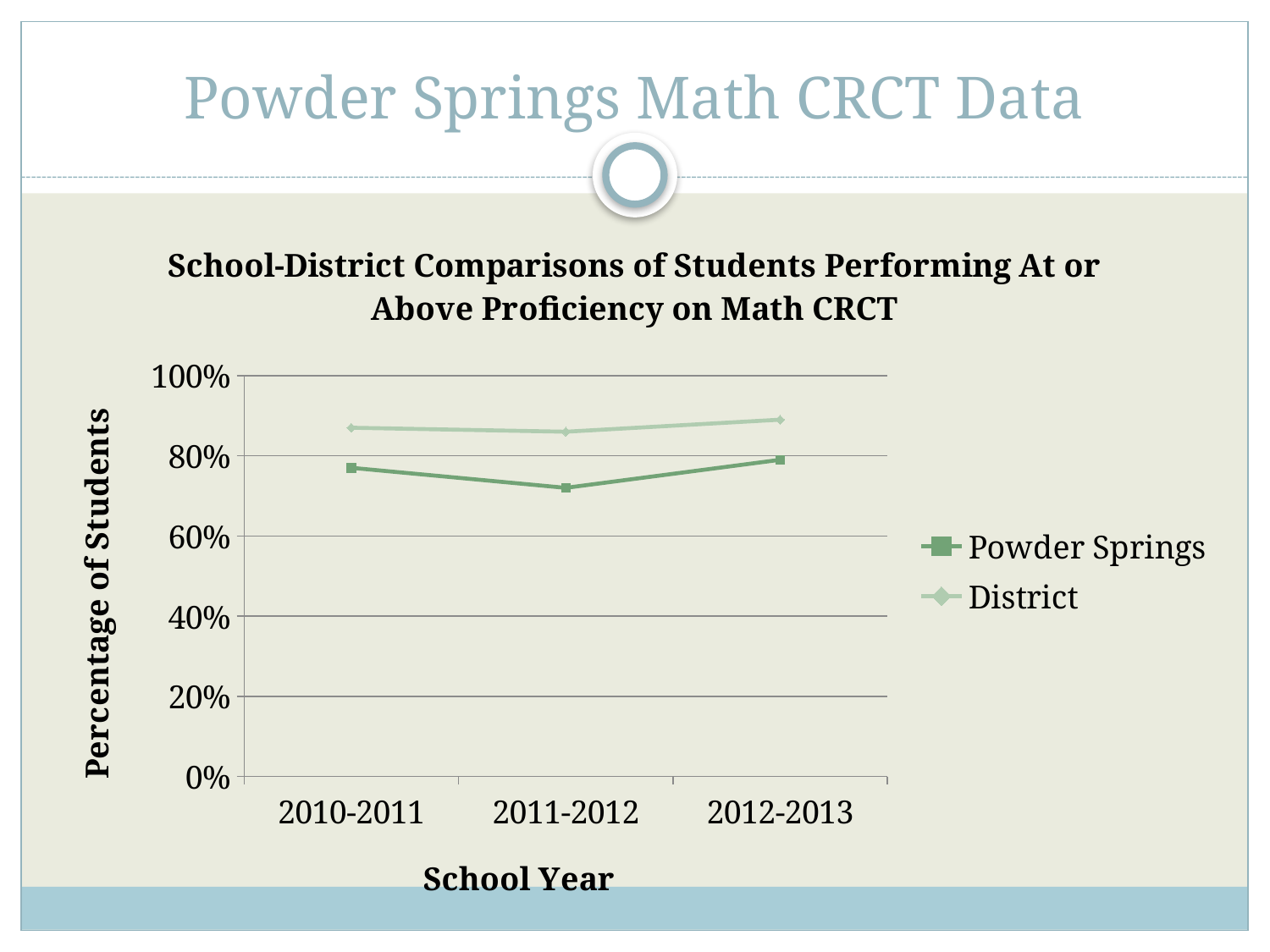
For Powder Springs, which is larger, the value for 2011-2012 or the value for 2012-2013? 2012-2013 How many school years are plotted on the x axis? 3 Is the value for Powder Springs in 2010-2011 greater or less than 80%? less Is the value for Powder Springs in 2011-2012 greater or less than 80%? less What kind of chart is shown on the slide? line chart In which school year is the Powder Springs value lowest? 2011-2012 What is the label on the y axis of the chart? Percentage of Students Which series has the higher value in 2012-2013, Powder Springs or District? District Does the Powder Springs line rise or fall from 2011-2012 to 2012-2013? rise Is the value for District in 2011-2012 greater or less than 80%? greater How many series does the legend list? 2